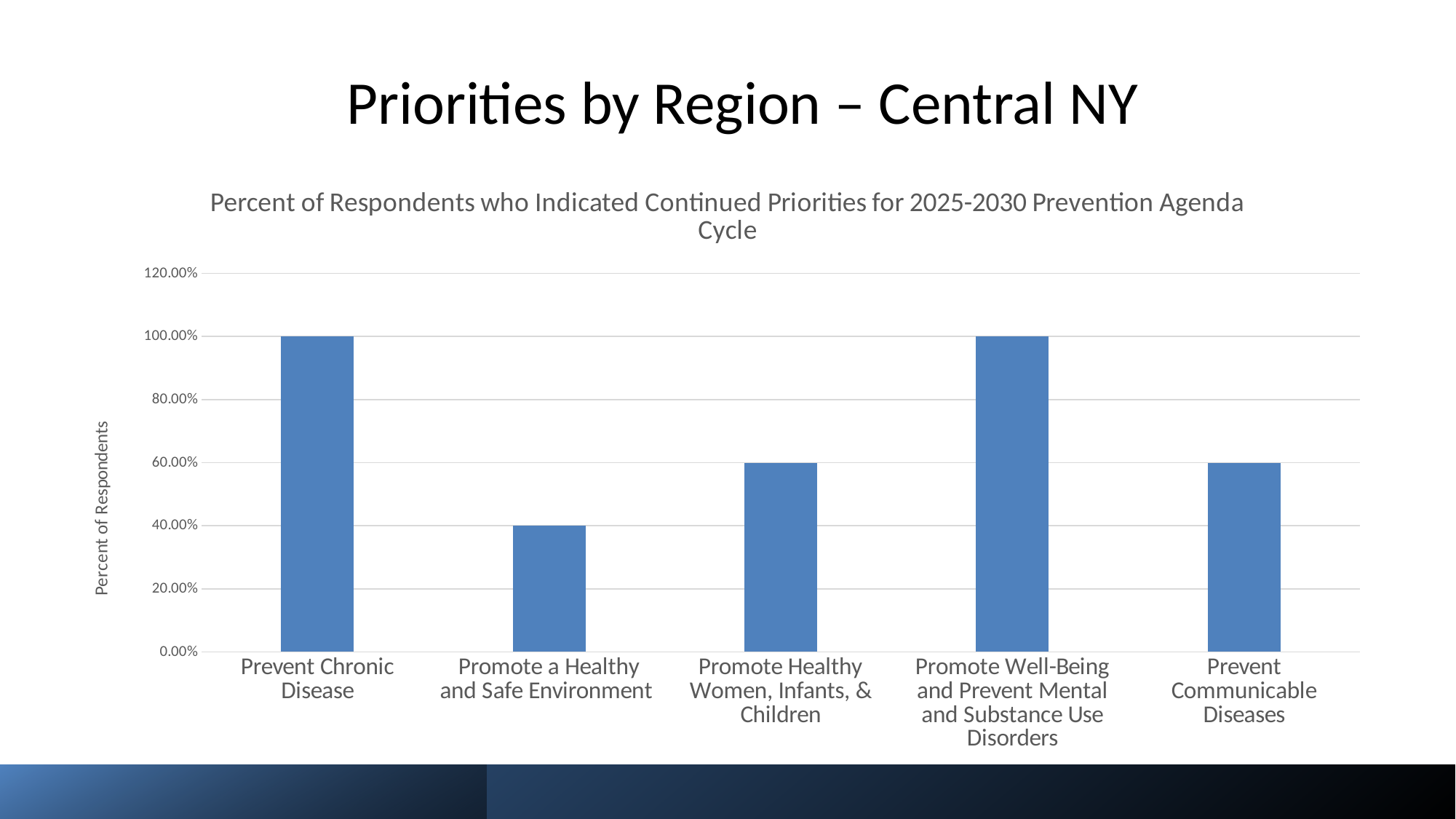
Which is larger, the value for Promote Well-Being and Prevent Mental and Substance Use Disorders or the value for Prevent Communicable Diseases? Promote Well-Being and Prevent Mental and Substance Use Disorders What is the difference between the values for Prevent Chronic Disease and Promote a Healthy and Safe Environment? 60.00% What is the title of the slide? Priorities by Region – Central NY What is the value for Promote Healthy Women, Infants, & Children? 60.00% What is the value for Prevent Communicable Diseases? 60.00% What is the value for Prevent Chronic Disease? 100.00% Is the value for Promote Healthy Women, Infants, & Children greater or less than 80.00%? less What kind of chart is shown on the slide? bar chart What is the label of the vertical axis? Percent of Respondents Which category has the lowest value? Promote a Healthy and Safe Environment How many categories are shown on the x axis? 5 What is the value for Promote a Healthy and Safe Environment? 40.00%